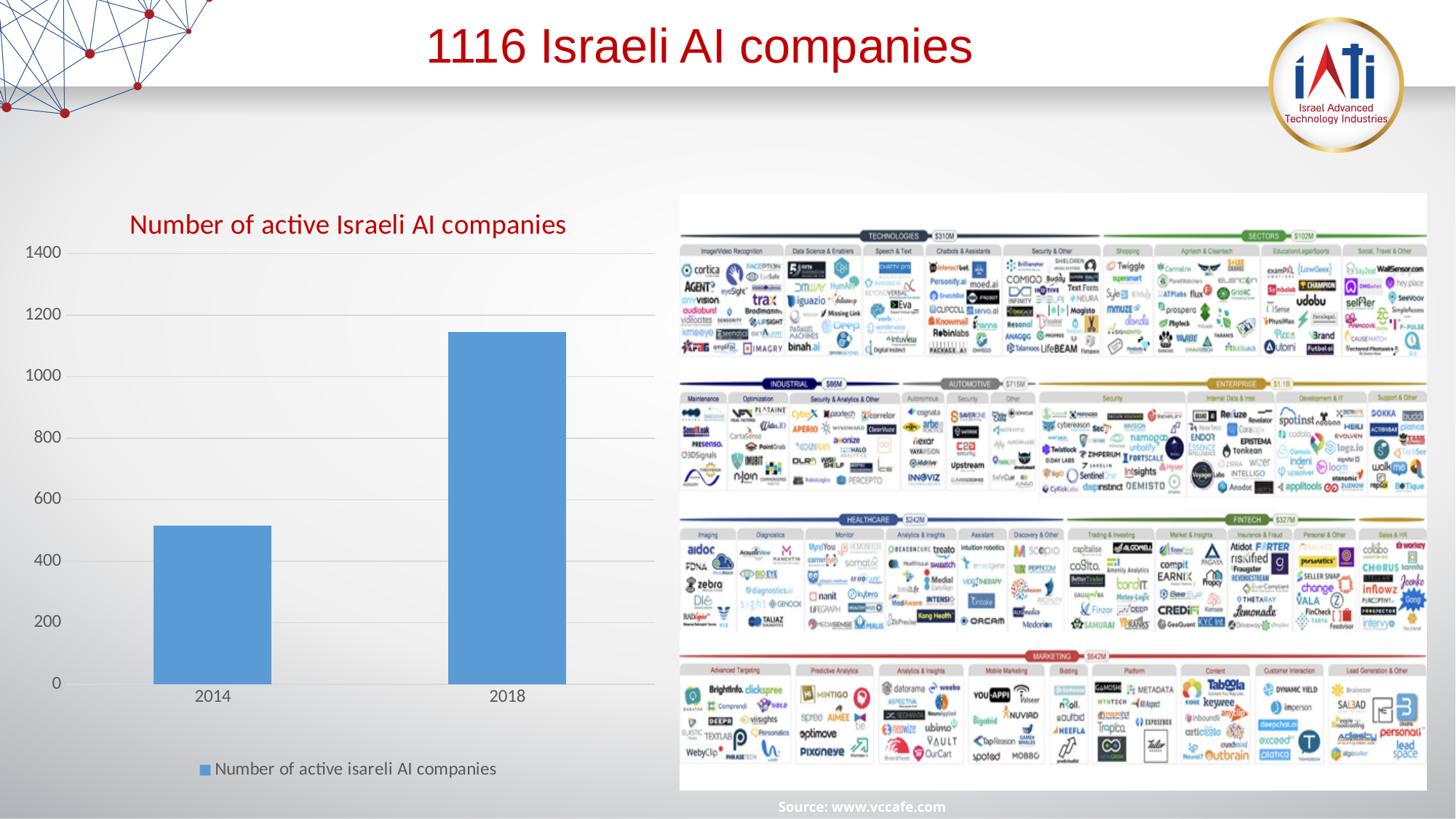
What kind of chart is shown on the left of the slide? bar chart Is the value for 2014 greater or less than 400? greater What is the highest value shown on the vertical axis of the bar chart? 1400 How many series does the legend of the bar chart list? 1 What is the title of the bar chart? Number of active Israeli AI companies Which year has the lower number of active Israeli AI companies in the bar chart? 2014 Is the bar for 2018 larger or smaller than the bar for 2014? larger Is the value for 2014 greater or less than 600? less Do the values in the bar chart rise or fall from 2014 to 2018? rise Is the value for 2018 greater or less than 1000? greater How many years are plotted in the bar chart? 2 Which year has the higher number of active Israeli AI companies in the bar chart? 2018